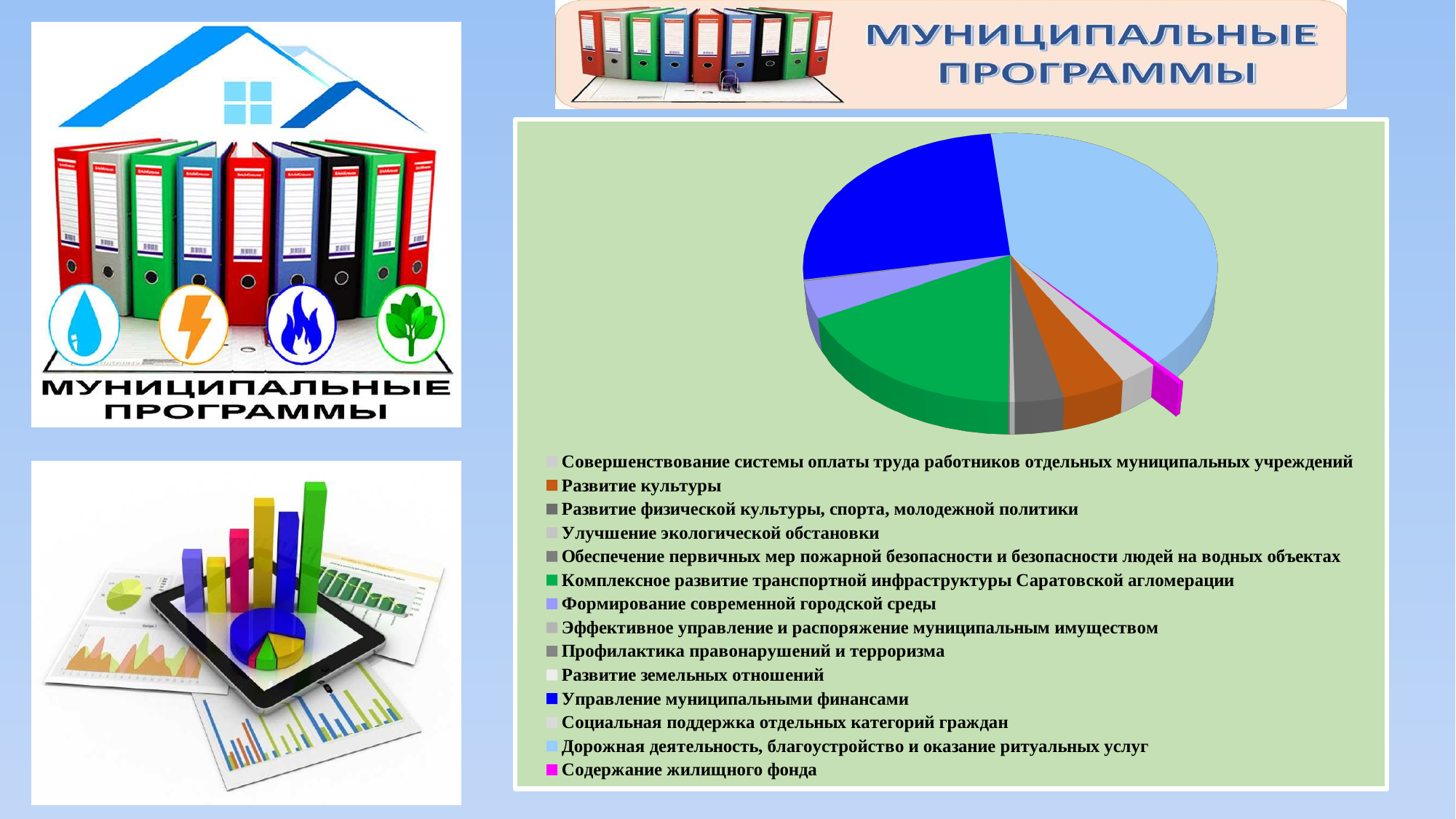
How many categories does the legend of the pie chart list? 14 Which slice is larger: Дорожная деятельность, благоустройство и оказание ритуальных услуг or Комплексное развитие транспортной инфраструктуры Саратовской агломерации? Дорожная деятельность, благоустройство и оказание ритуальных услуг What kind of chart is shown on the slide? Pie chart Which category has the largest slice of the pie chart? Дорожная деятельность, благоустройство и оказание ритуальных услуг Which slice is larger: Комплексное развитие транспортной инфраструктуры Саратовской агломерации or Содержание жилищного фонда? Комплексное развитие транспортной инфраструктуры Саратовской агломерации What colour is the slice for Управление муниципальными финансами in the pie chart? Blue Which slice is larger: Управление муниципальными финансами or Развитие культуры? Управление муниципальными финансами What colour is the slice for Содержание жилищного фонда in the pie chart? Magenta